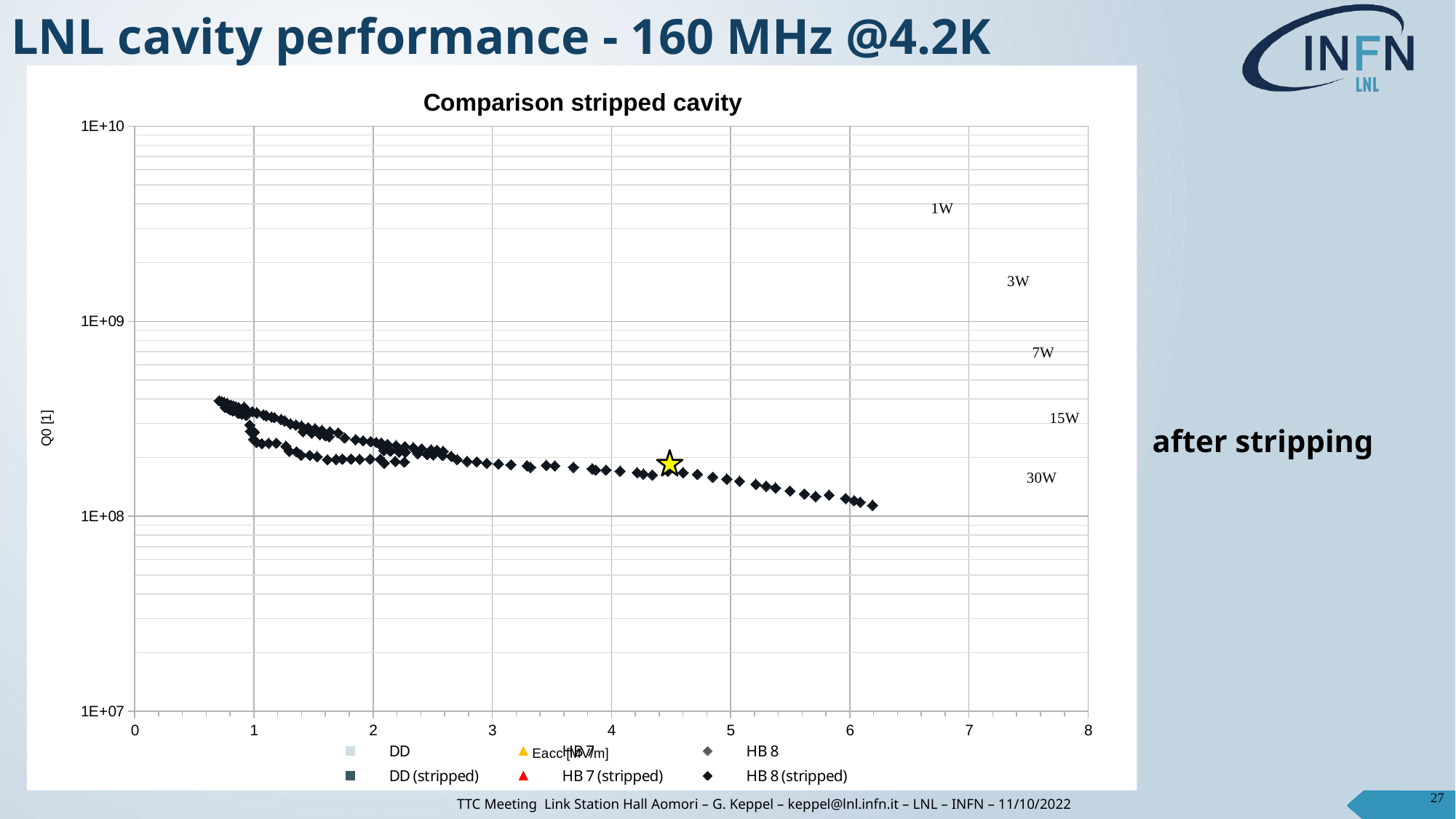
Is the Q0 value of the plotted points near Eacc = 1 greater or less than 1E+08? greater Is the Q0 value of the plotted points near Eacc = 1 greater or less than 1E+09? less What is the highest value shown on the y axis? 1E+10 What is the label of the y axis? Q0 [1] Do the plotted Q0 values rise or fall as Eacc increases along the x axis? Fall What kind of chart is shown on the slide? Scatter chart Is the Q0 value of the plotted points near Eacc = 6 greater or less than 1E+08? greater How many power-level lines (e.g. 1W, 3W) are labelled on the chart? 5 What is the title of the chart? Comparison stripped cavity Which has the higher Q0: the plotted points near Eacc = 1 or the plotted points near Eacc = 6? Near Eacc = 1 How many series does the chart legend list? 6